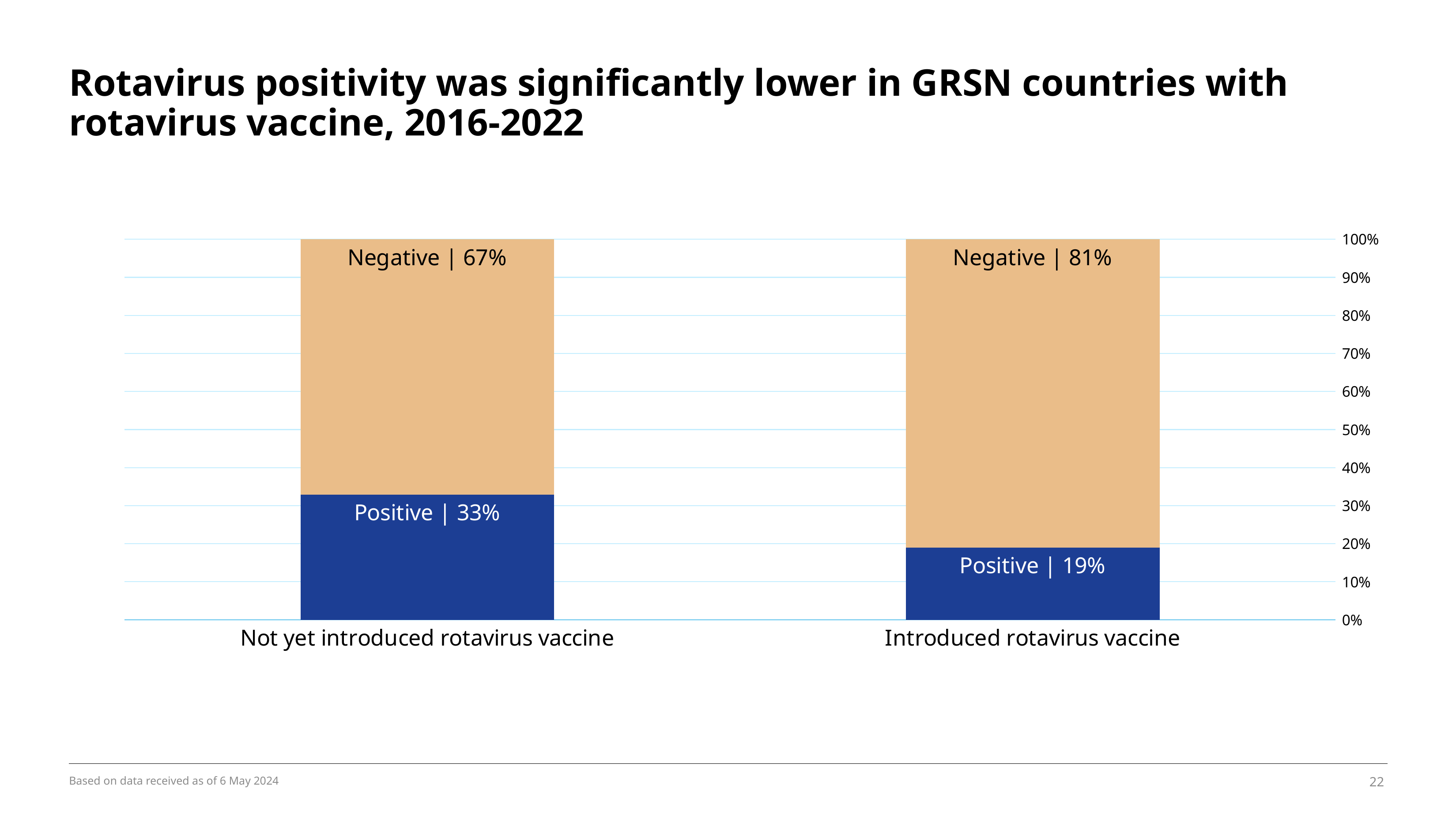
Is the negative percentage larger for countries that introduced rotavirus vaccine or for those that have not yet introduced it? Introduced rotavirus vaccine What kind of chart is shown on the slide? Stacked bar chart What is the difference in positive percentage between countries that have not yet introduced rotavirus vaccine and those that have? 14% What is the rotavirus positive percentage for countries that have not yet introduced rotavirus vaccine? 33% Which category has the higher positive percentage? Not yet introduced rotavirus vaccine What is the rotavirus positive percentage for countries that have introduced rotavirus vaccine? 19% What is the total of the stacked bar for countries that have not yet introduced rotavirus vaccine? 100% Which category has the lower positive percentage? Introduced rotavirus vaccine Is the positive percentage for countries that introduced rotavirus vaccine greater or less than 20%? less What is the negative percentage for countries that have not yet introduced rotavirus vaccine? 67% How many categories are shown on the x axis? 2 What is the negative percentage for countries that have introduced rotavirus vaccine? 81%